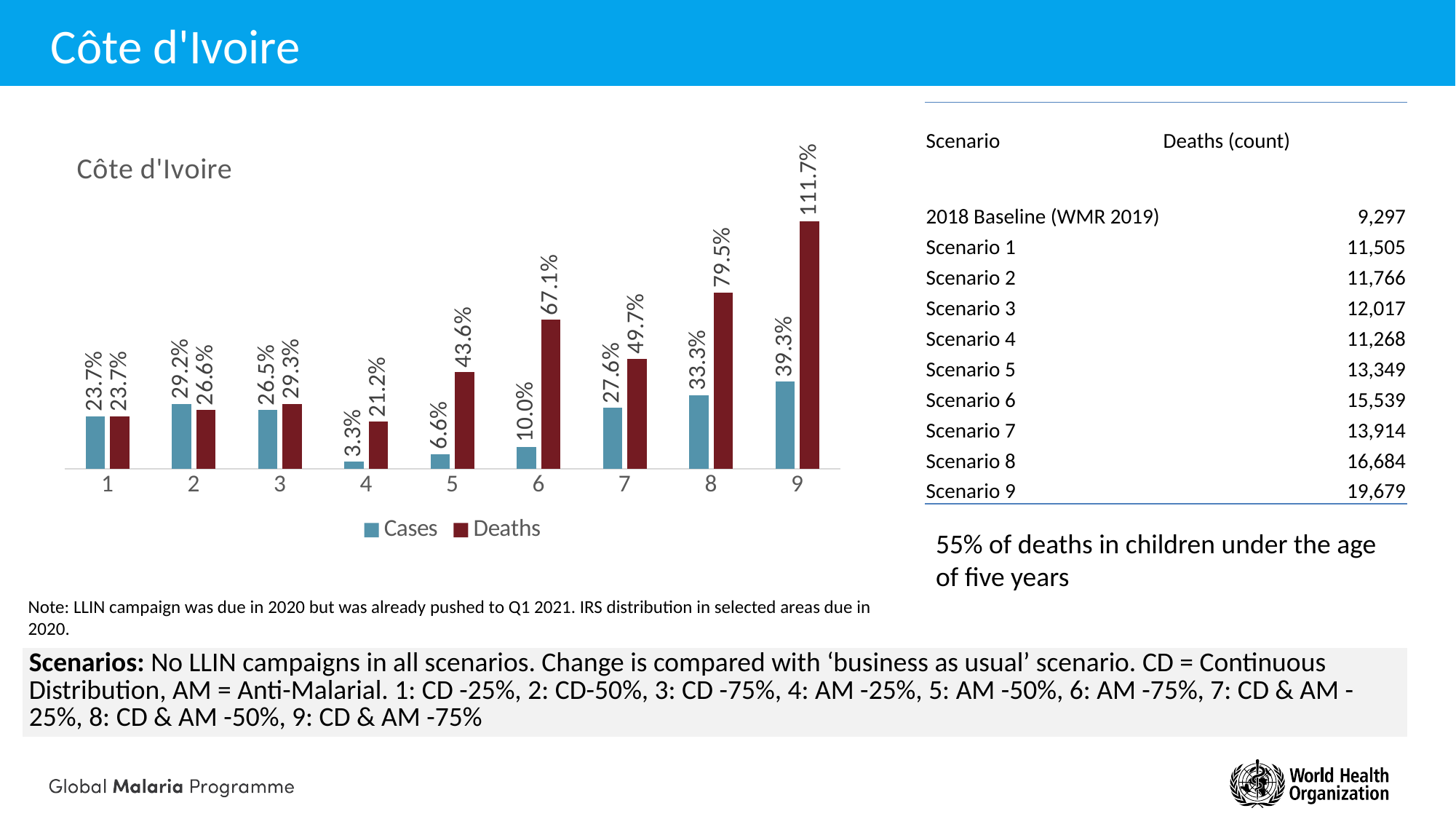
What is the Deaths value for scenario 9? 111.7% What is the title of the chart? Côte d'Ivoire What is the Cases value for scenario 1? 23.7% How many scenarios are shown on the x axis of the chart? 9 What is the Cases value for scenario 4? 3.3% What is the Deaths value for scenario 5? 43.6% Which scenario has the highest Deaths value? 9 How many series does the chart legend list? 2 Which is larger for scenario 8: the Cases value or the Deaths value? Deaths Which scenario has the lowest Cases value? 4 What is the difference between the Deaths and Cases values for scenario 6? 57.1% What kind of chart is shown on the slide? Bar chart